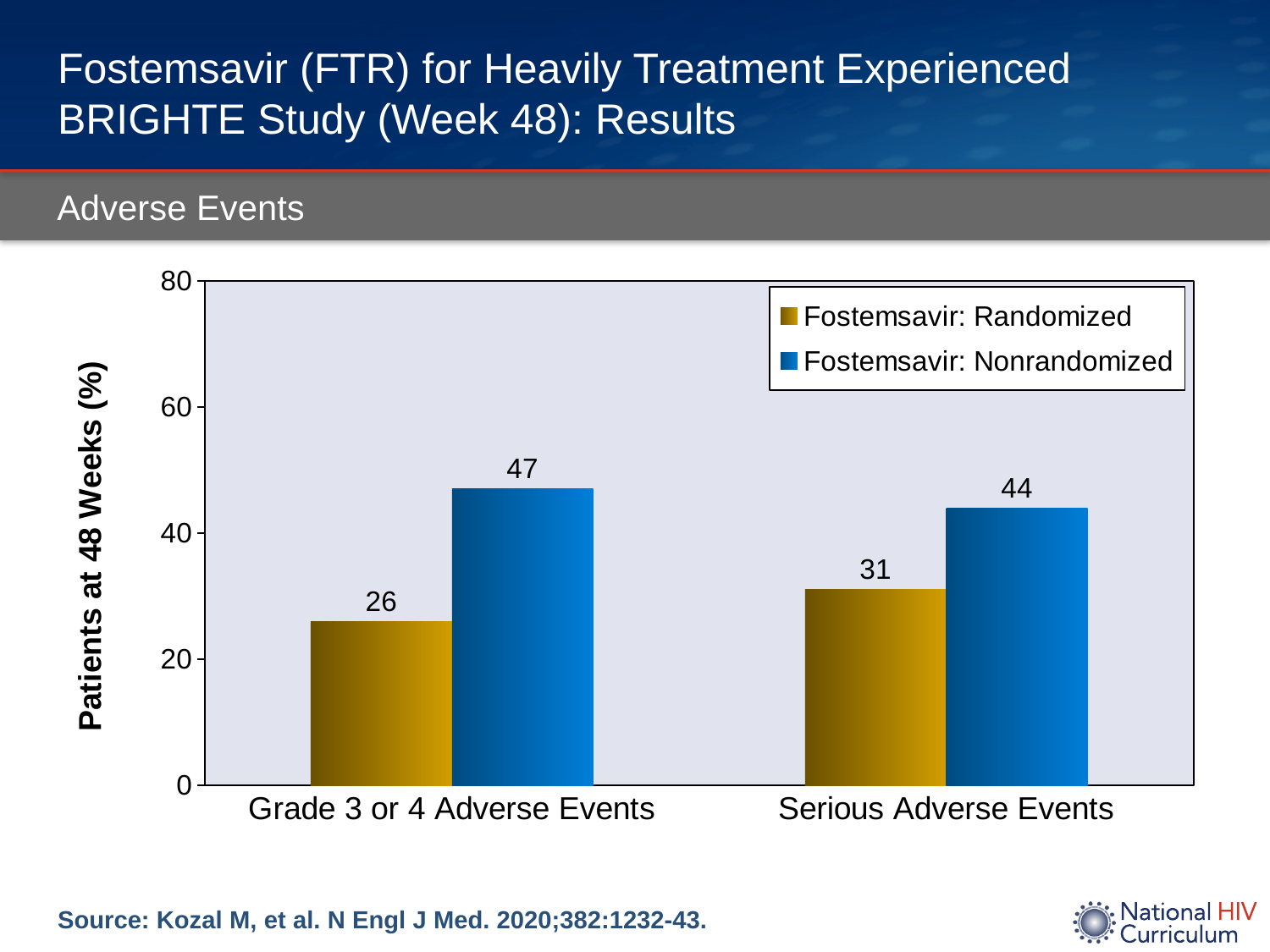
What percentage of patients in the Fostemsavir: Nonrandomized group had Serious Adverse Events? 44 What is the difference between the Nonrandomized and Randomized values for Grade 3 or 4 Adverse Events? 21 What percentage of patients in the Fostemsavir: Nonrandomized group had Grade 3 or 4 Adverse Events? 47 For Serious Adverse Events, which group has the larger value, Randomized or Nonrandomized? Fostemsavir: Nonrandomized What is the label of the y axis? Patients at 48 Weeks (%) What percentage of patients in the Fostemsavir: Randomized group had Serious Adverse Events? 31 Which group and category has the lowest value on the chart? Fostemsavir: Randomized, Grade 3 or 4 Adverse Events What is the difference between the Nonrandomized and Randomized values for Serious Adverse Events? 13 How many series does the legend list? 2 What percentage of patients in the Fostemsavir: Randomized group had Grade 3 or 4 Adverse Events? 26 Which group and category has the highest value on the chart? Fostemsavir: Nonrandomized, Grade 3 or 4 Adverse Events What kind of chart is shown on the slide? Bar chart